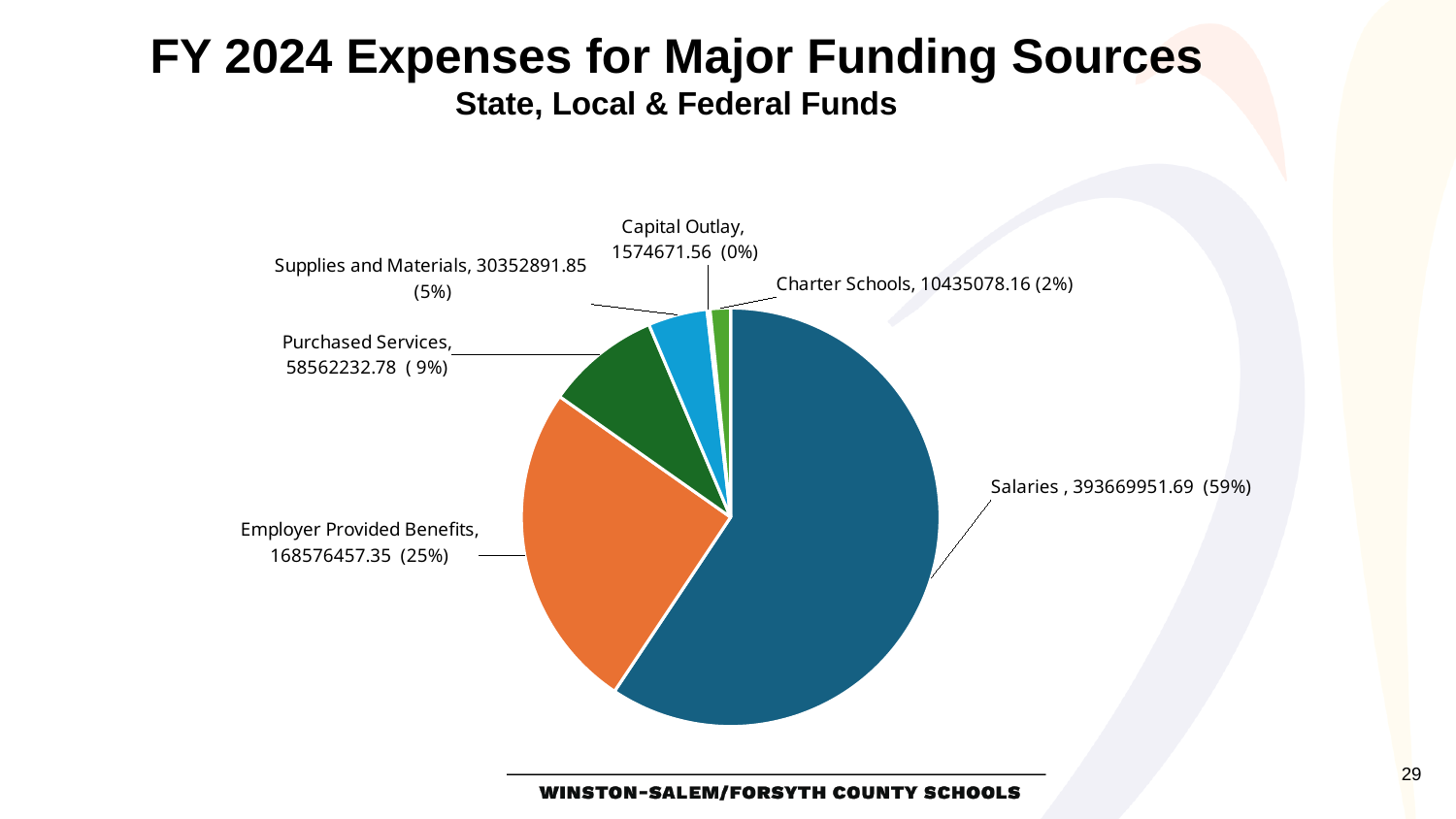
What is the difference between the values for Salaries and Employer Provided Benefits? 225093494.34 What share of the pie does Salaries represent? 59% How many categories are shown in the pie chart? 6 What is the value for Salaries? 393669951.69 Which is larger, Purchased Services or Supplies and Materials? Purchased Services Which category has the smallest slice of the pie? Capital Outlay What type of chart is shown on the slide? Pie chart What is the value for Employer Provided Benefits? 168576457.35 What is the value for Purchased Services? 58562232.78 What share of the pie does Employer Provided Benefits represent? 25% Which category has the largest slice of the pie? Salaries What is the value for Charter Schools? 10435078.16